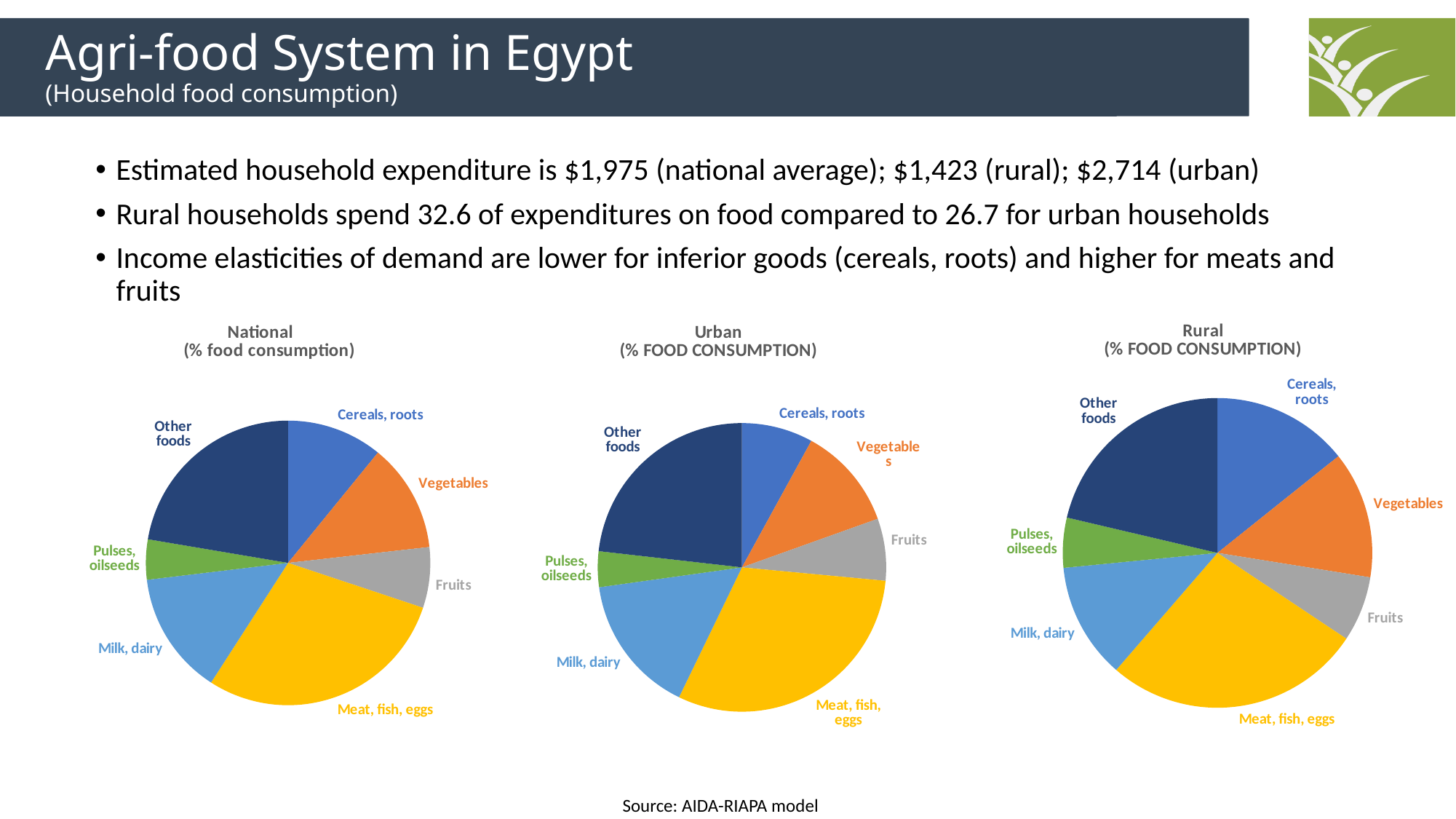
In the National (% food consumption) chart, which category has the largest slice? Meat, fish, eggs In the Urban (% FOOD CONSUMPTION) chart, which slice is larger: Other foods or Milk, dairy? Other foods How many categories does the Urban (% FOOD CONSUMPTION) pie chart show? 7 In the Rural (% FOOD CONSUMPTION) chart, which category has the largest slice? Meat, fish, eggs In the National (% food consumption) chart, which category has the smallest slice? Pulses, oilseeds In the Rural (% FOOD CONSUMPTION) chart, which slice is larger: Cereals, roots or Fruits? Cereals, roots What kind of chart is the National (% food consumption) chart? pie chart In the National (% food consumption) chart, which slice is larger: Other foods or Fruits? Other foods In the Urban (% FOOD CONSUMPTION) chart, which category has the smallest slice? Pulses, oilseeds In the Rural (% FOOD CONSUMPTION) chart, which category has the smallest slice? Pulses, oilseeds In the Urban (% FOOD CONSUMPTION) chart, which category has the largest slice? Meat, fish, eggs How many pie charts are shown on the slide? 3